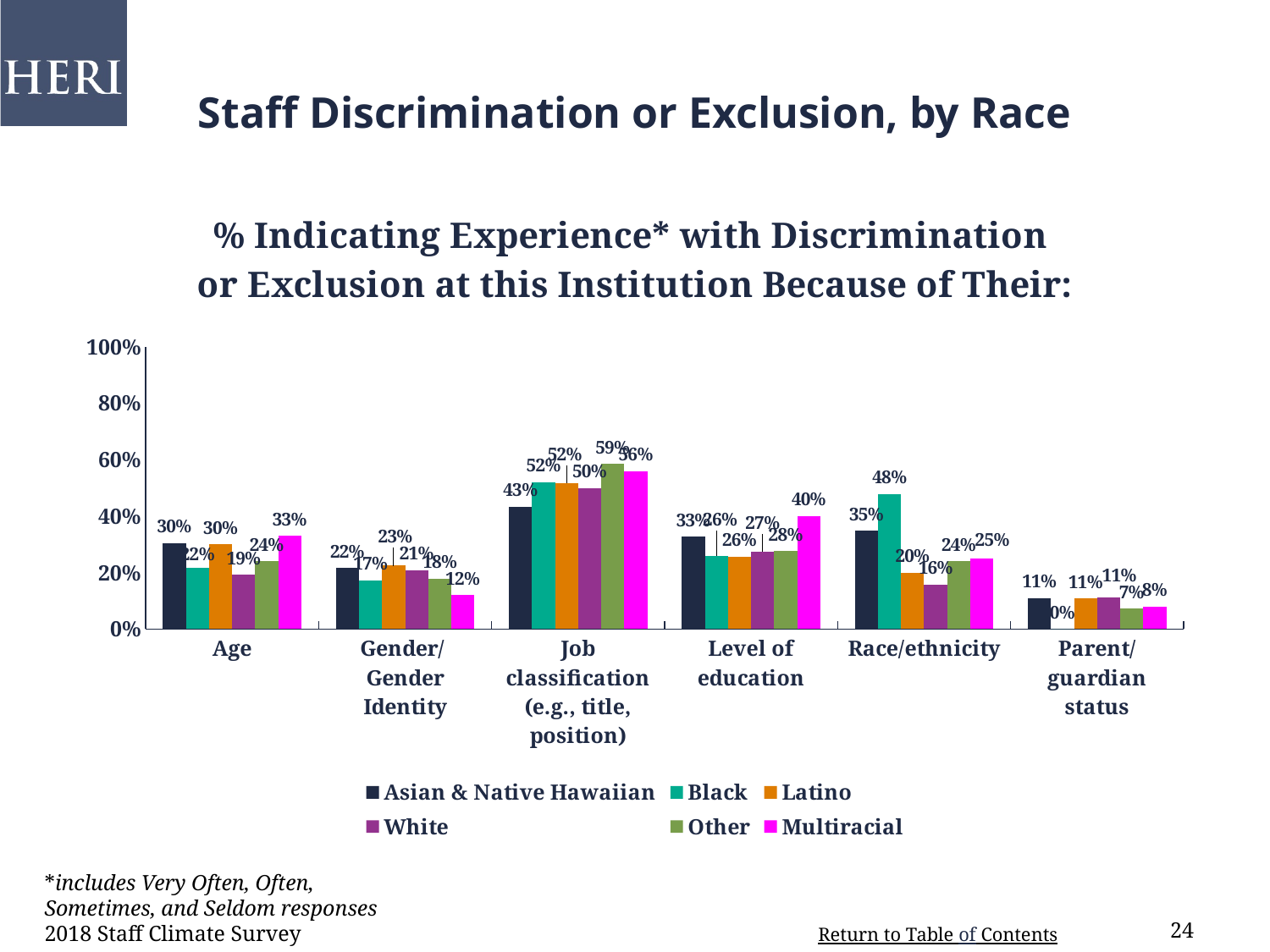
Is the value for Other staff in the Job classification category greater or less than 40%? greater In the Level of education category, which is larger: the Multiracial value or the Asian & Native Hawaiian value? Multiracial What percentage of Multiracial staff indicated experience with discrimination or exclusion because of their age? 33% What is the difference between the Black and White values in the Race/ethnicity category? 32 percentage points How many categories of discrimination or exclusion are shown on the x axis? 6 How many racial groups does the legend list? 6 What percentage of Multiracial staff indicated experience with discrimination or exclusion because of their gender/gender identity? 12% What type of chart is shown on the slide? Bar chart Which racial group has the highest value in the Race/ethnicity category? Black What percentage of Black staff indicated experience with discrimination or exclusion because of their race/ethnicity? 48% What percentage of Asian & Native Hawaiian staff indicated experience with discrimination or exclusion because of their job classification? 43% Which racial group has the lowest value in the Parent/guardian status category? Black